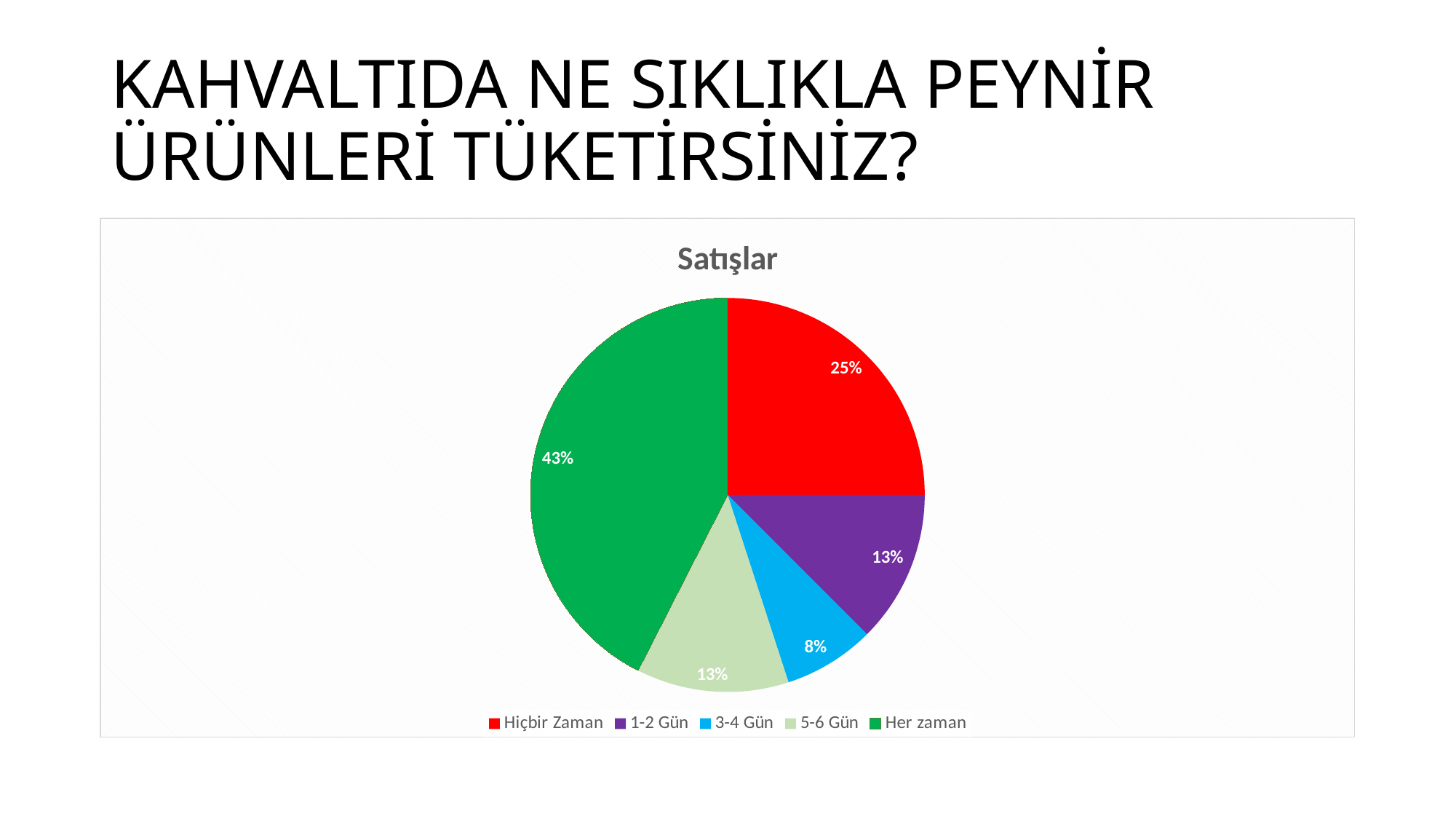
How many categories does the pie chart show? 5 What is the difference in percentage points between the 'Her zaman' slice and the 'Hiçbir Zaman' slice? 18 What colour is the 'Hiçbir Zaman' slice? Red What is the value shown for the '1-2 Gün' slice? 13% What share of the pie does the 'Her zaman' slice represent? 43% What is the value shown for the '3-4 Gün' slice? 8% What share of the pie does the 'Hiçbir Zaman' slice represent? 25% Which category has the smallest slice of the pie? 3-4 Gün Which is larger, the 'Hiçbir Zaman' slice or the '5-6 Gün' slice? Hiçbir Zaman Which category has the largest slice of the pie? Her zaman What is the title of the chart? Satışlar What kind of chart is shown on the slide? Pie chart